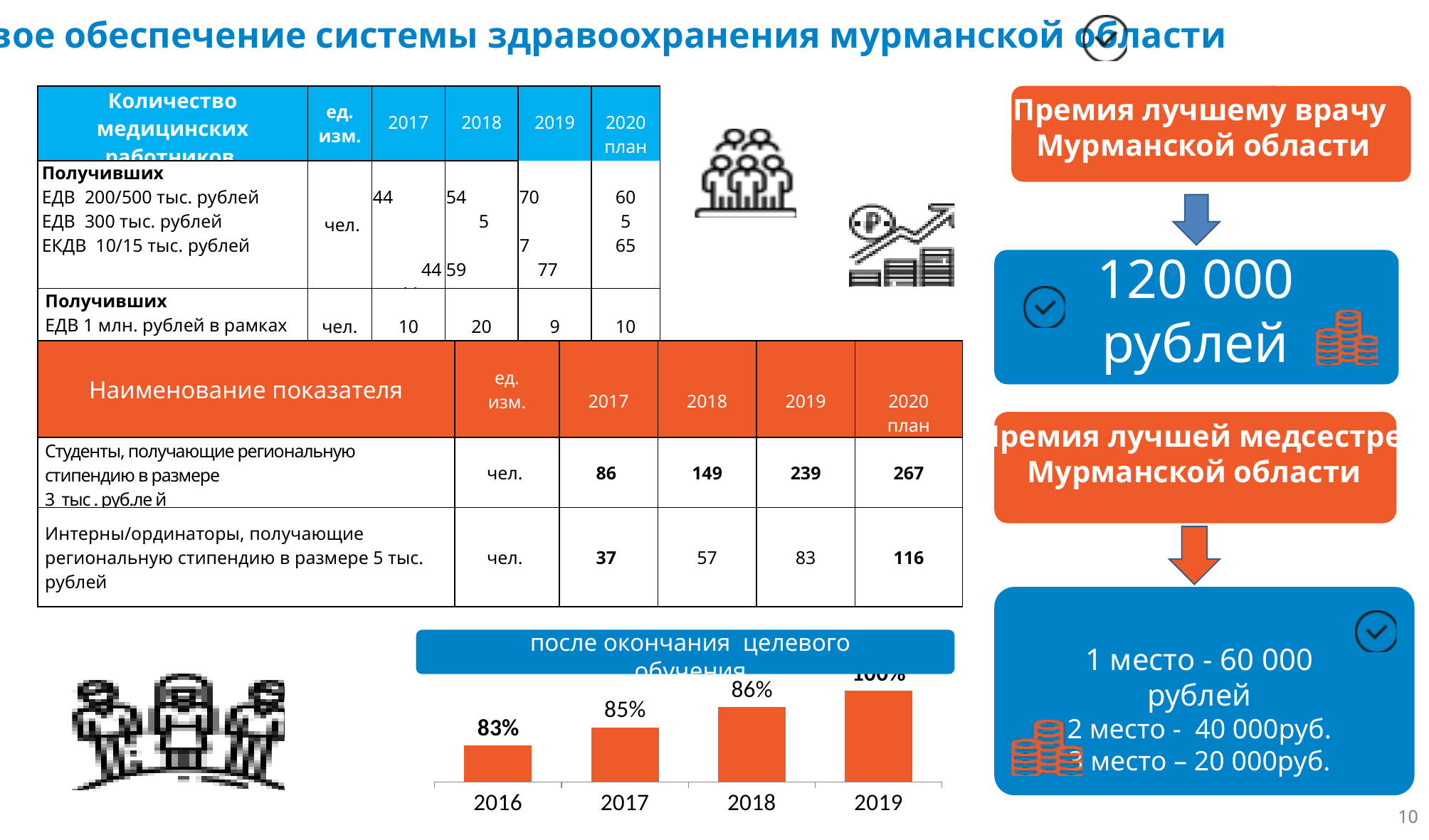
In the bar chart at the bottom of the slide, what is the value for 2018? 86% In the bar chart at the bottom of the slide, what is the value for 2019? 100% In the bar chart at the bottom of the slide, which is larger: the value for 2017 or the value for 2019? 2019 In the bar chart at the bottom of the slide, what is the value for 2016? 83% How many years (bars) are shown in the bar chart at the bottom of the slide? 4 In the bar chart at the bottom of the slide, which year has the highest value? 2019 In the bar chart at the bottom of the slide, what is the value for 2017? 85% What type of chart is shown at the bottom of the slide? bar chart In the bar chart at the bottom of the slide, which year has the lowest value? 2016 In the bar chart at the bottom of the slide, do the values rise or fall from 2016 to 2019? rise In the bar chart at the bottom of the slide, what is the difference between the values for 2018 and 2017? 1% In the bar chart at the bottom of the slide, what is the difference between the values for 2019 and 2016? 17%